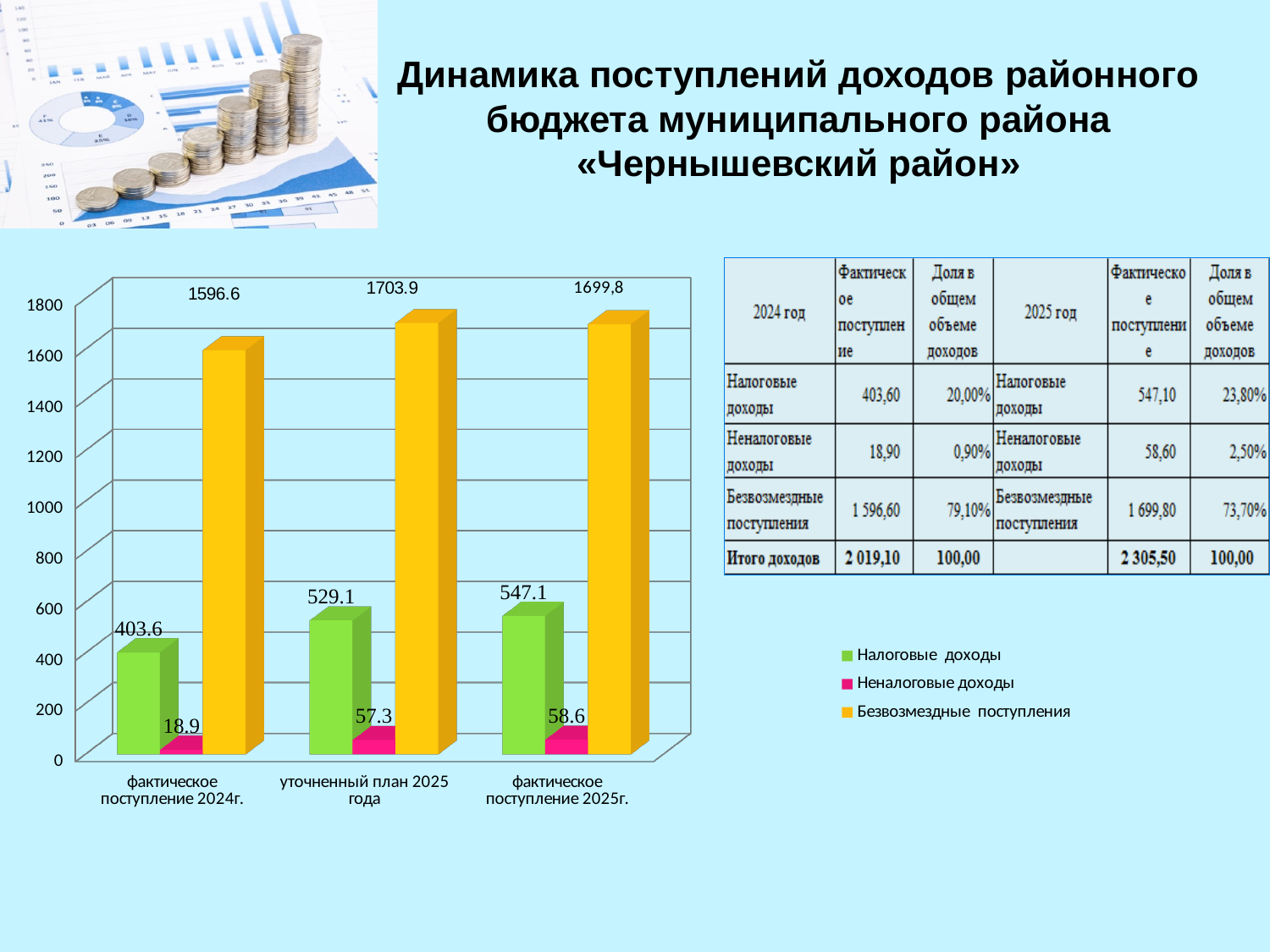
What is the value of Налоговые доходы for фактическое поступление 2024г.? 403.6 How many categories are shown on the x axis of the chart? 3 Which series is shown in yellow in the chart? Безвозмездные поступления How many series does the chart legend list? 3 What kind of chart is shown on the slide? bar chart What is the value of Безвозмездные поступления for уточненный план 2025 года? 1703.9 What is the difference between Налоговые доходы for фактическое поступление 2025г. and for фактическое поступление 2024г.? 143.5 What is the value of Неналоговые доходы for уточненный план 2025 года? 57.3 Which category has the lowest value for Безвозмездные поступления? фактическое поступление 2024г. Which is larger: Безвозмездные поступления for уточненный план 2025 года or for фактическое поступление 2025г.? уточненный план 2025 года What is the value of Неналоговые доходы for фактическое поступление 2025г.? 58.6 Which category has the highest value for Налоговые доходы? фактическое поступление 2025г.